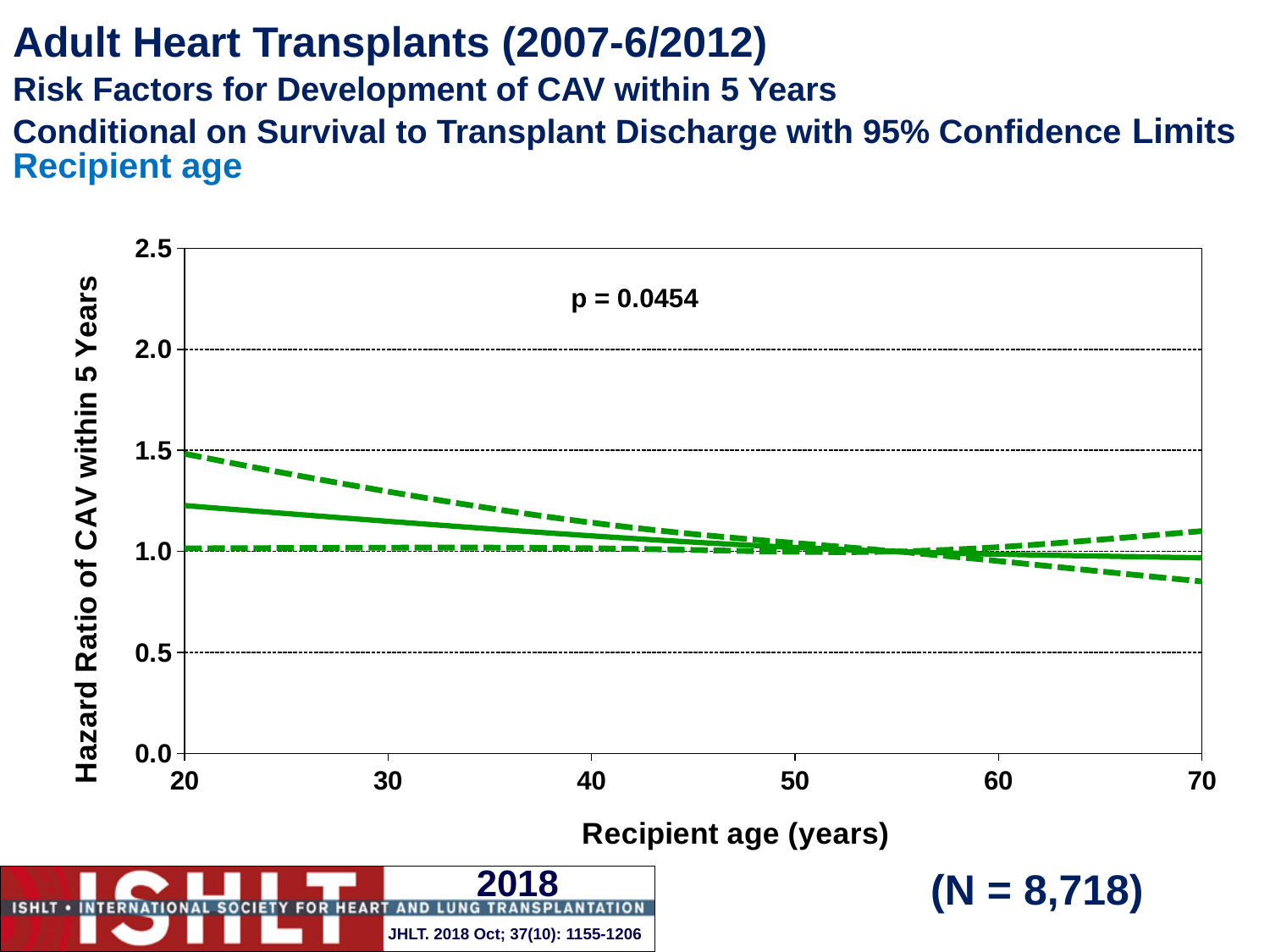
What p-value is printed on the chart? p = 0.0454 What kind of chart is shown on the slide? line chart Does the solid hazard ratio line rise or fall as recipient age increases from 20 to 70 years? fall Is the hazard ratio on the solid line at recipient age 20 greater or less than 1.0? greater What is the sample size (N) shown on the slide? N = 8,718 Is the lower dashed confidence limit at recipient age 70 greater or less than 1.0? less Is the hazard ratio on the solid line at recipient age 20 greater or less than 1.5? less How many lines are plotted on the chart? 3